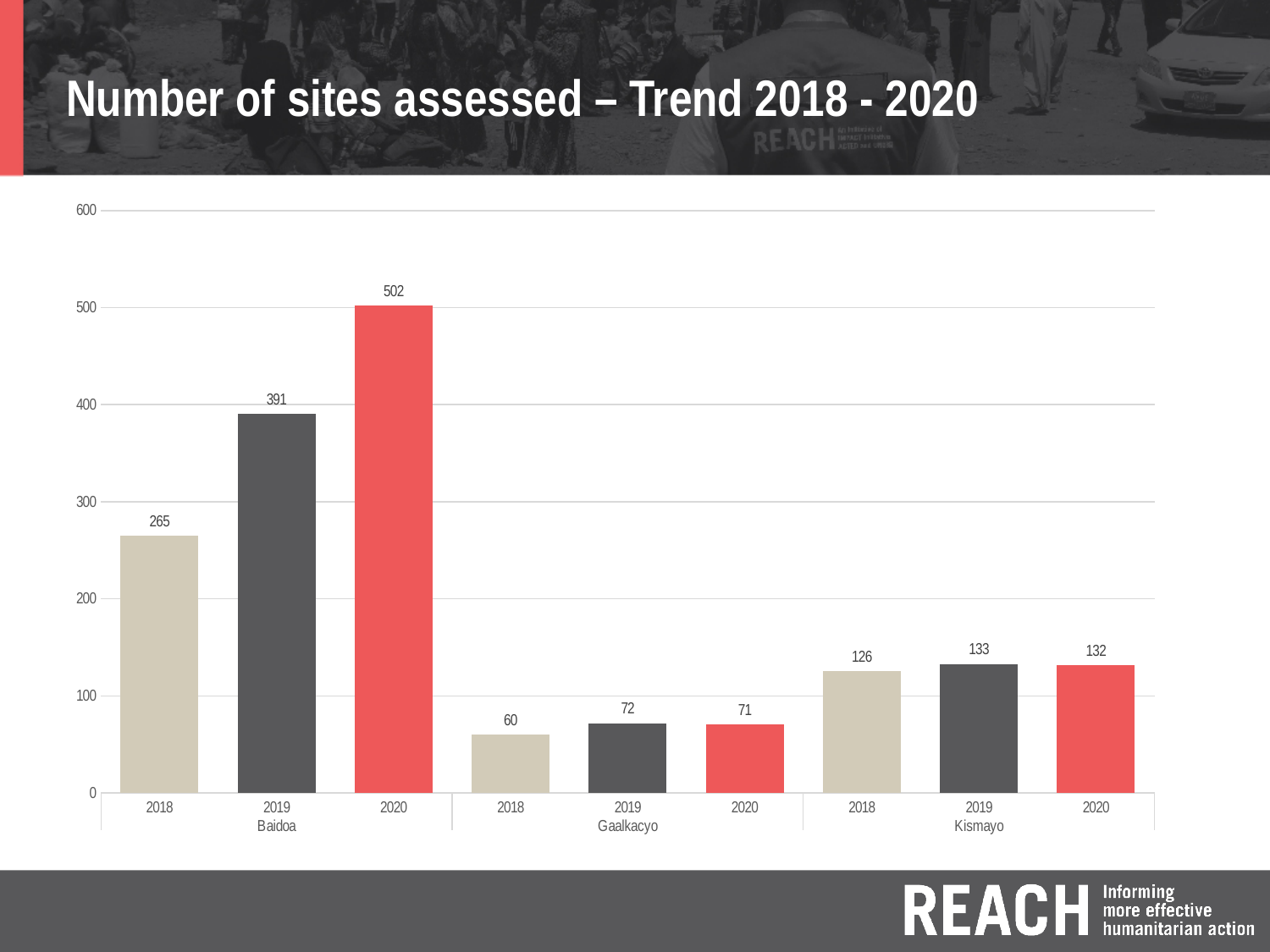
What kind of chart is shown on the slide? bar chart How many bars are plotted on the chart? 9 Which bar has the lowest value on the chart? Gaalkacyo 2018 Which bar has the highest value on the chart? Baidoa 2020 What is the value for Kismayo in 2019? 133 What is the number of sites assessed in Gaalkacyo in 2018? 60 What is the difference between the Baidoa values for 2020 and 2019? 111 Do the Baidoa values rise or fall from 2018 to 2020? rise What is the difference between the Kismayo values for 2018 and 2019? 7 How many sites were assessed in Baidoa in 2020? 502 Which is larger: Baidoa in 2018 or Kismayo in 2018? Baidoa in 2018 Is the value for Baidoa in 2019 greater or less than 400? less